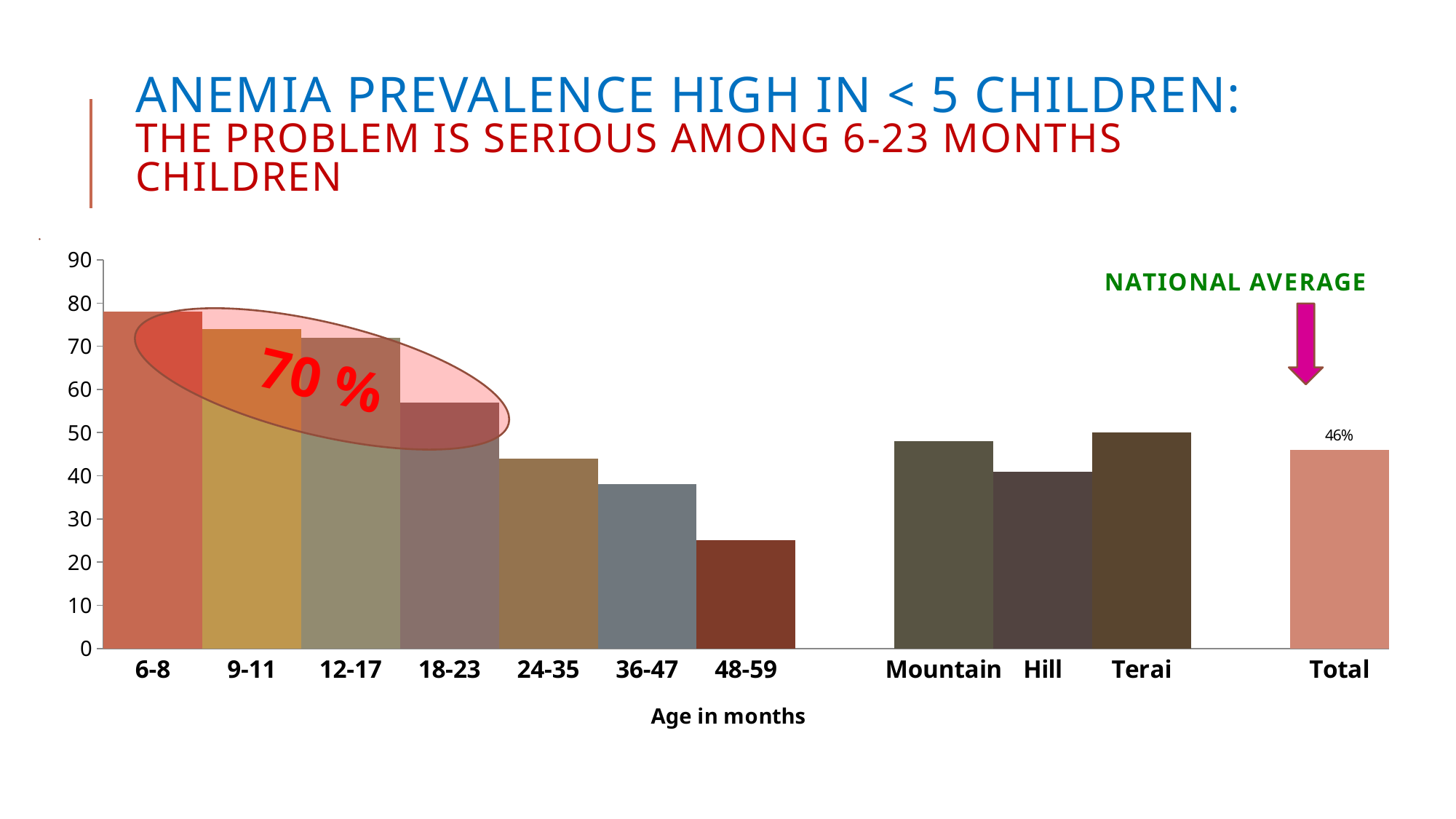
What kind of chart is shown on the slide? bar chart Is the value for 6-8 greater or less than 70? greater Is the value for 48-59 greater or less than 30? less How many categories are shown on the x axis? 11 Which is larger, the value for 18-23 or the value for 24-35? 18-23 Is the value for Hill greater or less than 50? less Which is larger, the value for Mountain or the value for Hill? Mountain Which category has the highest bar? 6-8 Which bar does the 'NATIONAL AVERAGE' arrow point to? Total Do the values rise or fall across the age groups from 6-8 to 48-59? fall What value is shown for the Total bar? 46% Which category has the lowest bar? 48-59